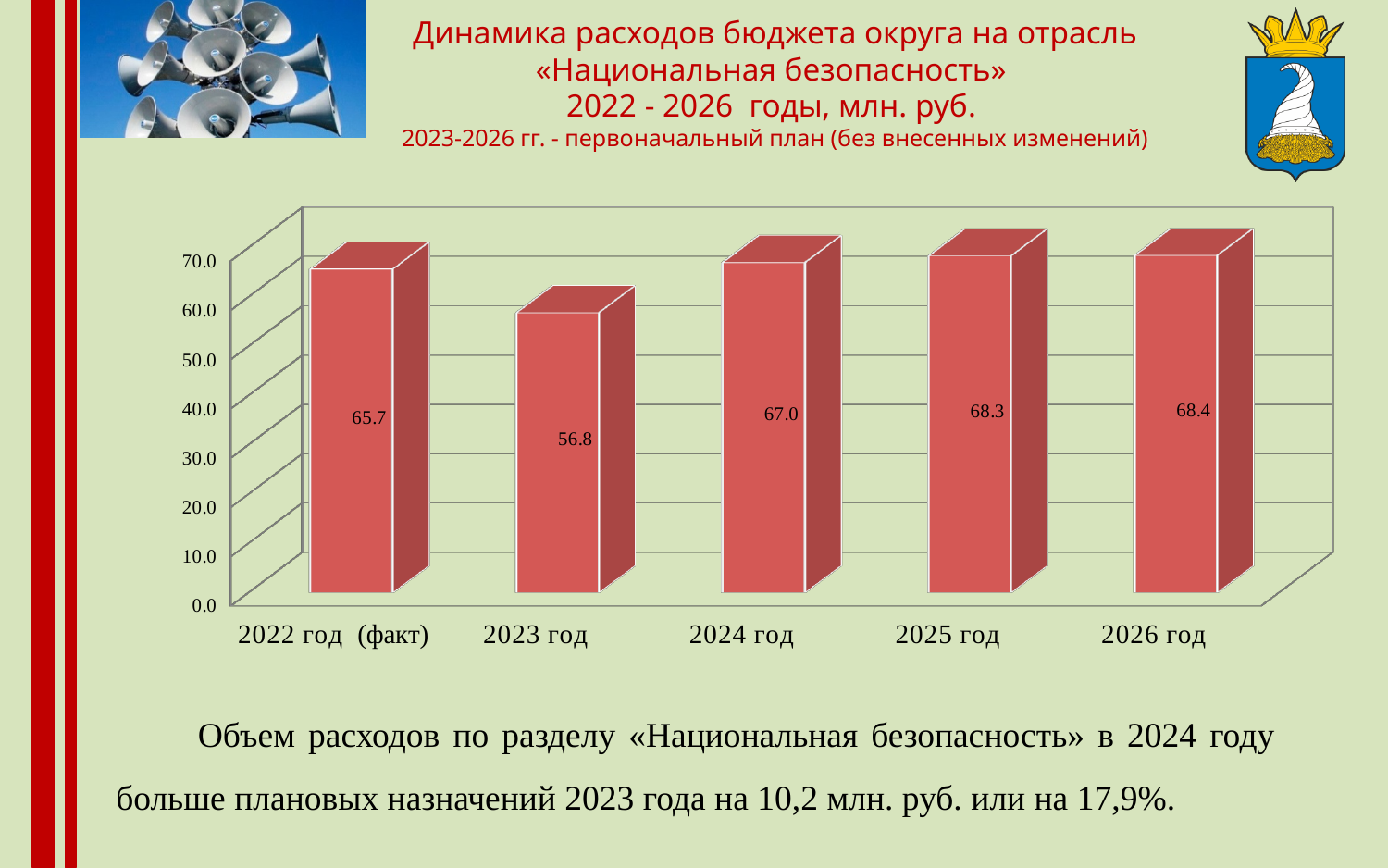
How many years are shown on the chart? 5 What kind of chart is shown on the slide? bar chart Is the value for 2023 год greater or less than 60.0? less Which year has the lowest value? 2023 год What is the value for 2023 год? 56.8 What is the difference between the values for 2024 год and 2023 год? 10.2 Which year has the highest value? 2026 год Which is larger, the value for 2022 год (факт) or the value for 2023 год? 2022 год (факт) What is the value for 2022 год (факт)? 65.7 What colour are the bars on the chart? red Do the values rise or fall from 2023 год to 2026 год? rise What is the value for 2025 год? 68.3